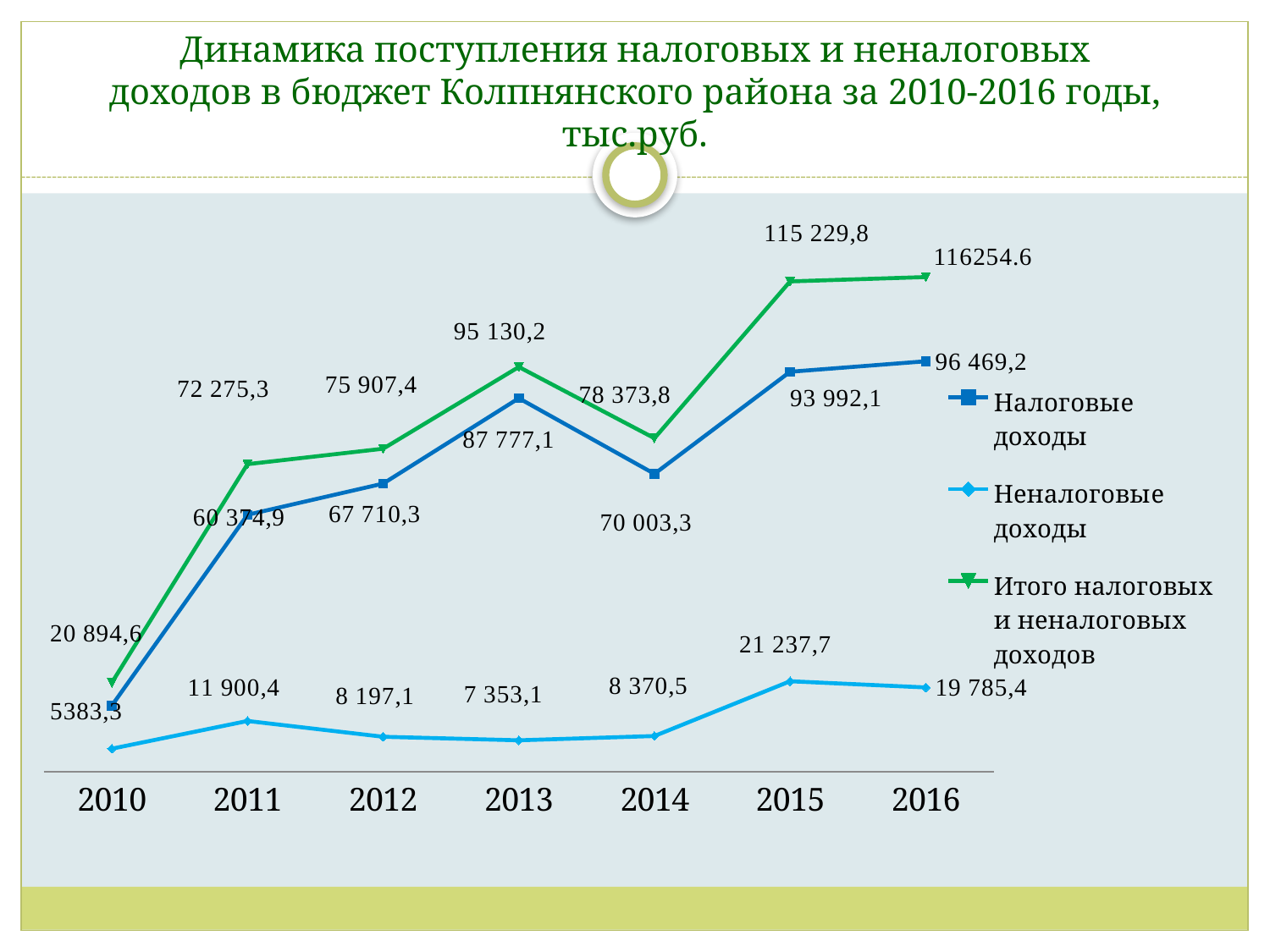
What type of chart is shown on the slide? line chart How many years are shown on the x axis? 7 What is the value of Налоговые доходы in 2013? 87 777,1 How many series does the legend list? 3 Which is larger: Налоговые доходы in 2013 or in 2014? 2013 In which year is Итого налоговых и неналоговых доходов highest? 2016 In which year is Неналоговые доходы lowest? 2013 What is the difference between Налоговые доходы in 2016 and in 2015? 2 477,1 Which series is drawn in green? Итого налоговых и неналоговых доходов What is the value of Итого налоговых и неналоговых доходов in 2010? 20 894,6 What is the value of Неналоговые доходы in 2015? 21 237,7 Does Неналоговые доходы rise or fall from 2011 to 2013? fall